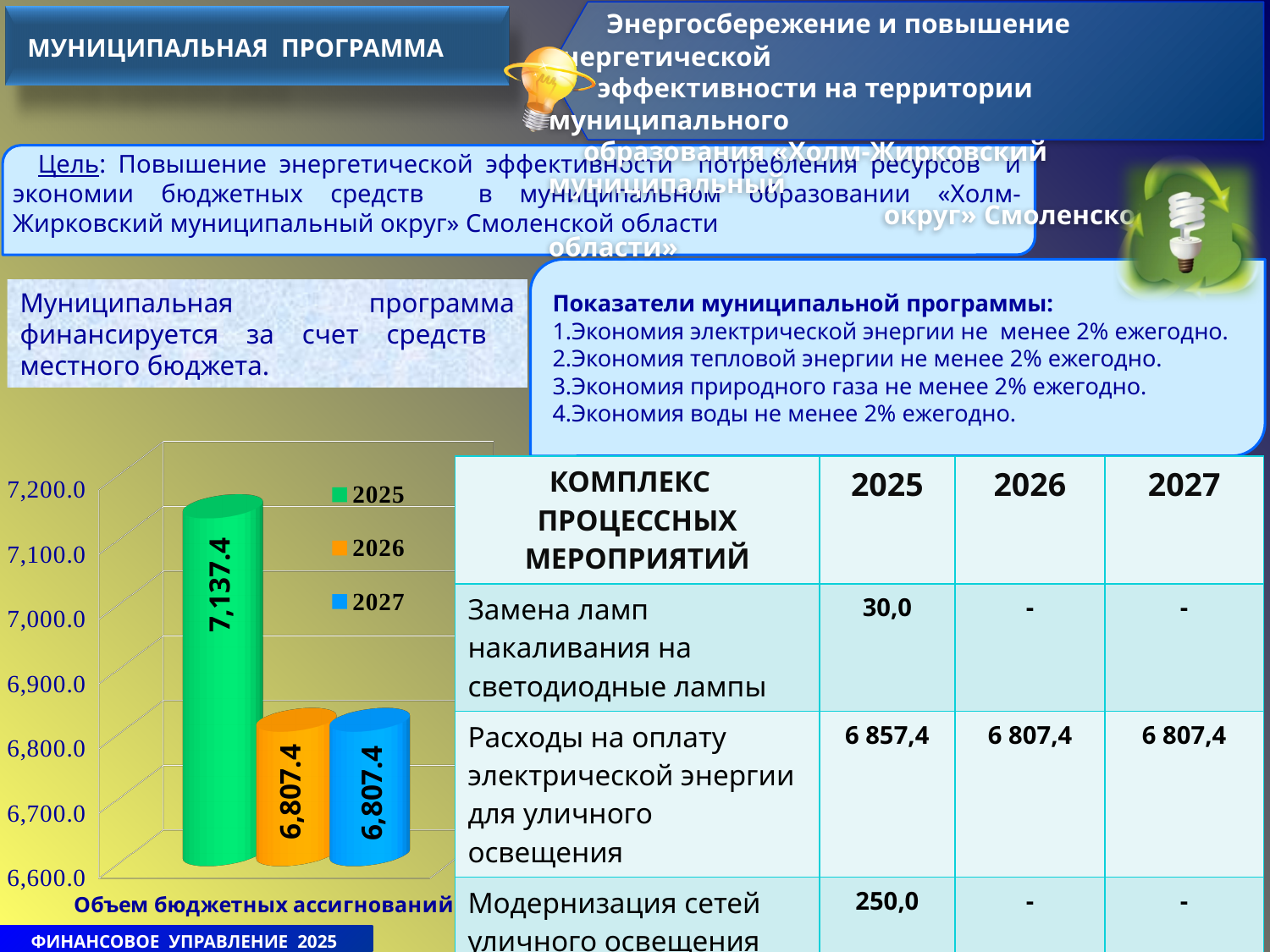
What kind of chart is shown on the slide? bar chart Is the value for 2025 in the chart greater or less than 7,100.0? greater What is the value of the 2026 bar in the chart? 6,807.4 What is the difference between the 2025 and 2026 values in the chart? 330.0 What is the value of the 2027 bar in the chart? 6,807.4 Is the value for 2026 in the chart greater or less than 6,900.0? less Which year has the highest value in the chart? 2025 What colour is the 2025 bar in the chart? green How many bars are plotted in the chart? 3 How many entries does the chart legend list? 3 Which is larger in the chart, the value for 2025 or the value for 2027? 2025 What is the value of the 2025 bar in the chart? 7,137.4